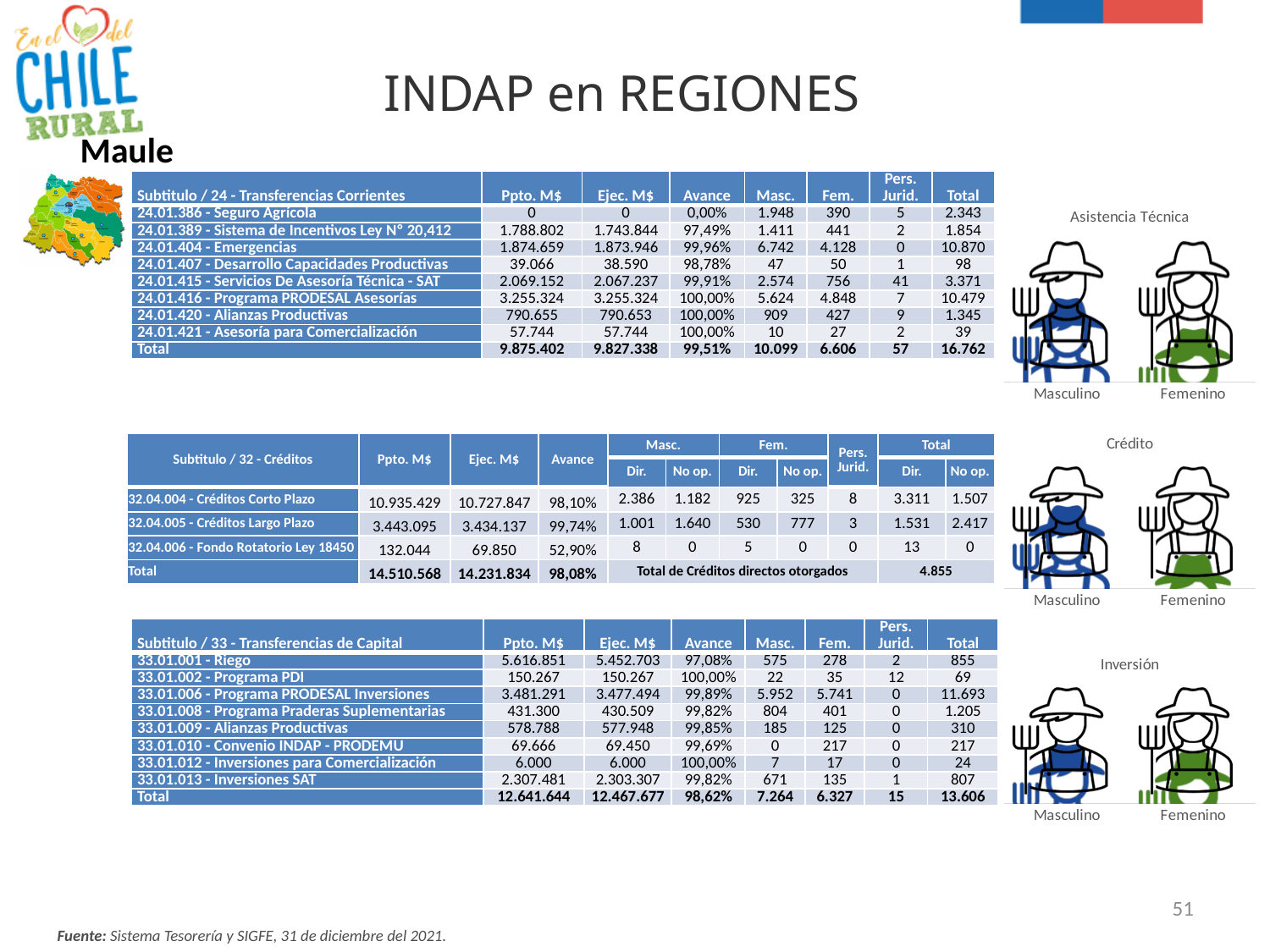
In the 'Asistencia Técnica' pictogram chart, which figure is filled more, Masculino or Femenino? Masculino What are the titles of the three pictogram charts on the slide? Asistencia Técnica, Crédito, Inversión In the 'Crédito' pictogram chart, which figure is filled more, Masculino or Femenino? Masculino How many categories does the 'Asistencia Técnica' pictogram chart show? 2 What kind of chart is used under the heading 'Asistencia Técnica' on the right of the slide? pictogram (icon) chart What colour is used to fill the Femenino figure in the pictogram charts? green How many pictogram charts are shown on the right side of the slide? 3